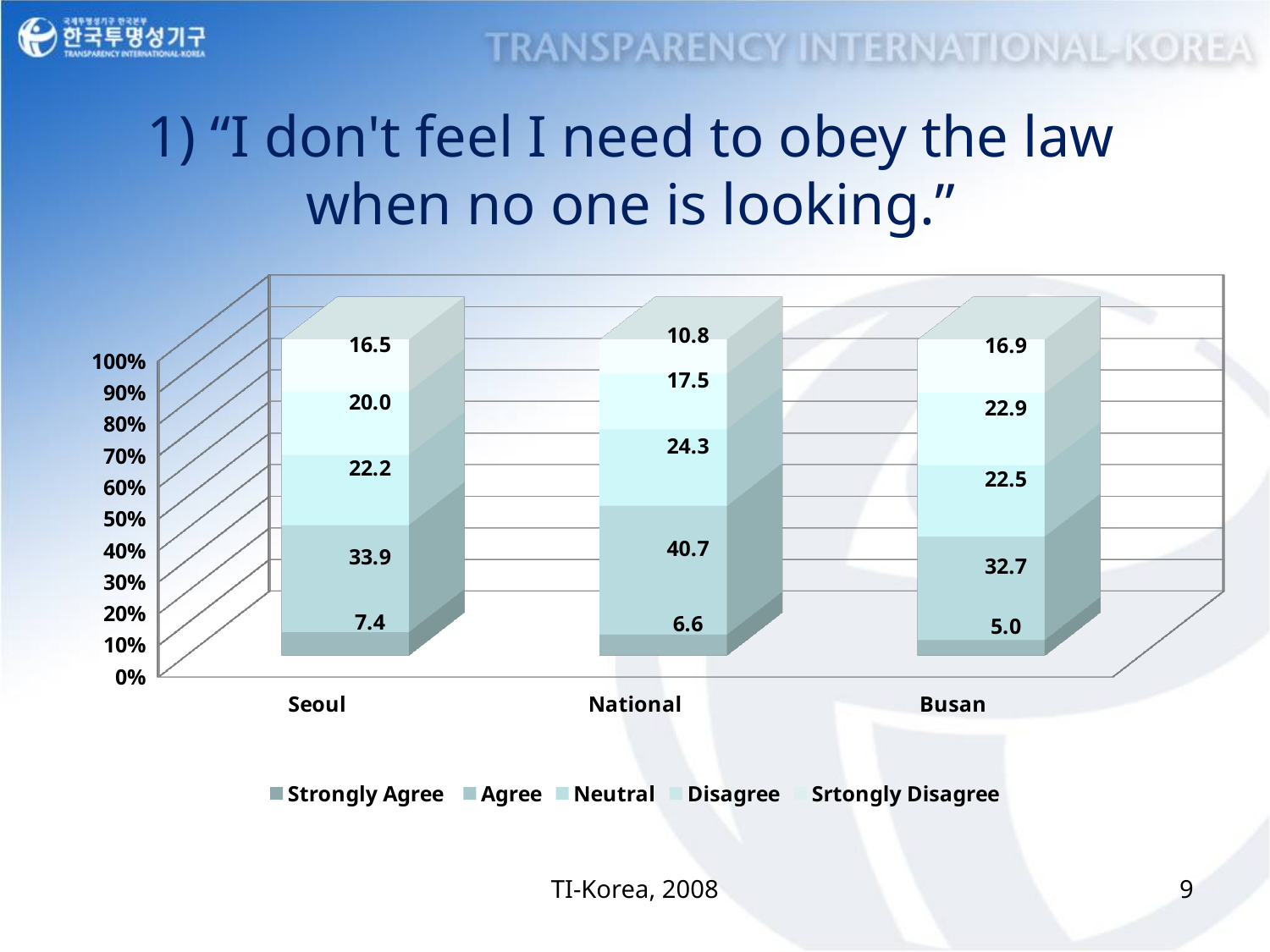
Which is larger, the Disagree value for Busan or the Disagree value for National? Busan What is the Agree value for National? 40.7 What is the Disagree value for Seoul? 20.0 How many series does the chart's legend list? 5 What is the Neutral value for Busan? 22.5 What is the Strongly Agree value for Seoul? 7.4 Which category has the highest Agree value? National What is the difference between the Agree values for National and Busan? 8.0 What type of chart is shown on the slide? Stacked bar chart Which category has the lowest Strongly Agree value? Busan How many categories are shown on the x axis of the chart? 3 What is the last series name listed in the legend, as written on the slide? Srtongly Disagree